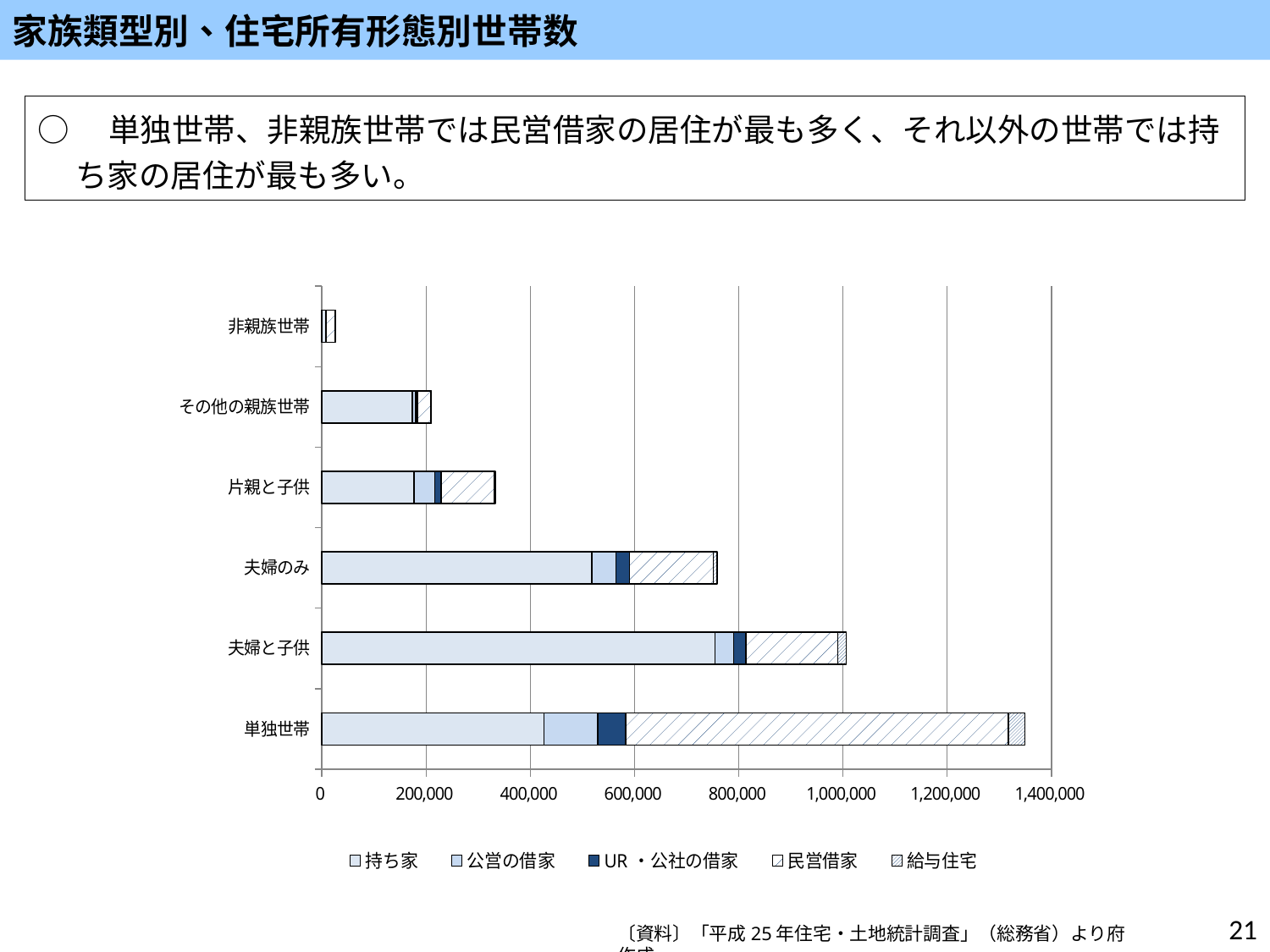
What is the title of the slide containing the chart? 家族類型別、住宅所有形態別世帯数 Which household type has the shortest total bar? 非親族世帯 How many household types (categories) are plotted on the chart? 6 Which has the longer total bar, 片親と子供 or その他の親族世帯? 片親と子供 Is the total bar length for 単独世帯 greater or less than 1,200,000? greater How many series does the legend list? 5 Is the total bar length for 夫婦のみ greater or less than 600,000? greater Which household type has the longest total bar? 単独世帯 Is the total bar length for 非親族世帯 greater or less than 200,000? less Which has the longer total bar, 夫婦と子供 or 夫婦のみ? 夫婦と子供 What kind of chart is shown on the slide? Stacked bar chart